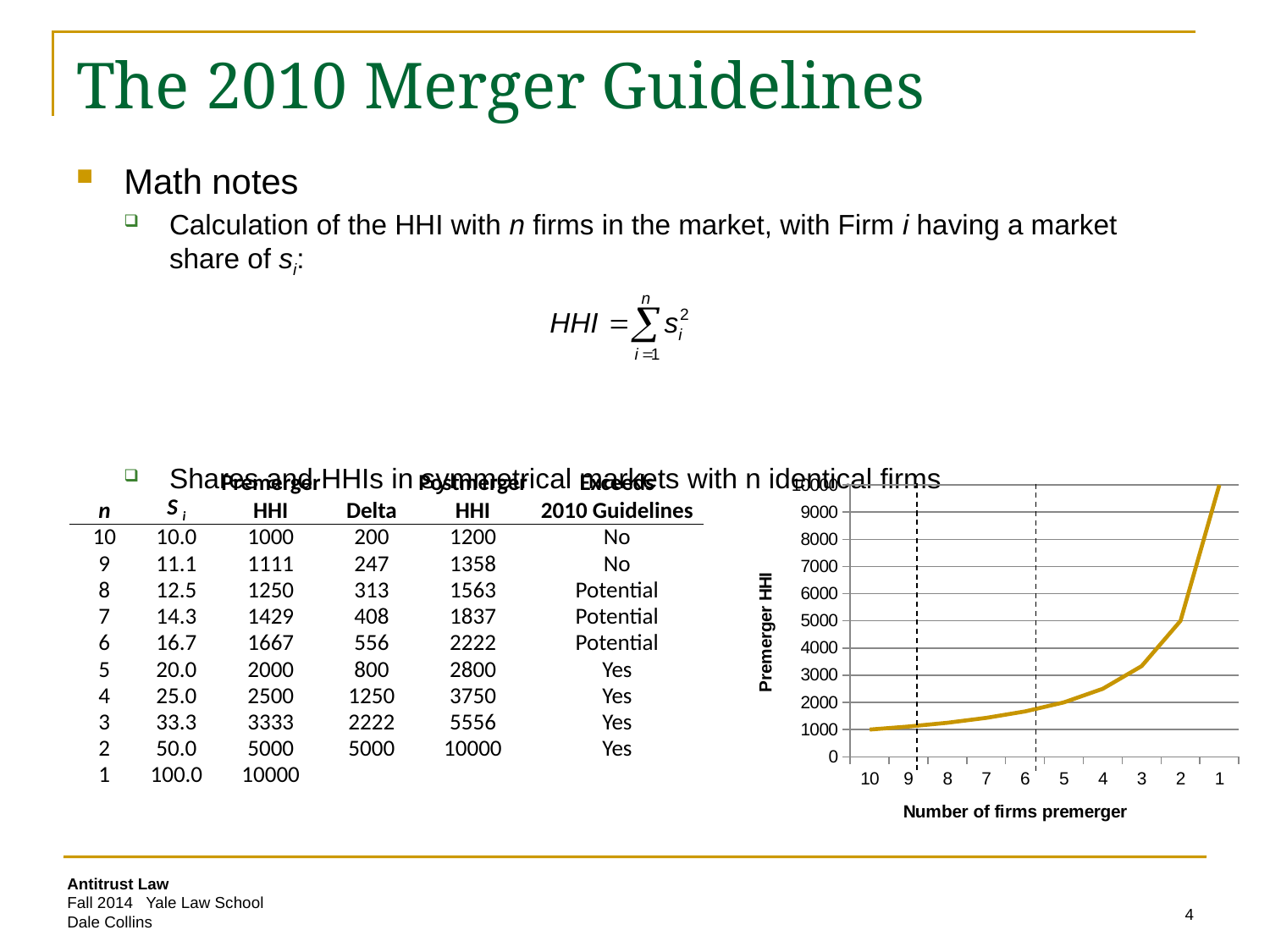
What is the title of the x axis of the chart? Number of firms premerger Is the Premerger HHI for 6 firms greater or less than 2000? less What type of chart is shown on the right side of the slide? line chart What is the Premerger HHI when there is 1 firm premerger? 10000 Does the Premerger HHI rise or fall as you move from left to right along the x axis (from 10 firms to 1 firm)? rise Is the Premerger HHI for 4 firms greater or less than 2000? greater What is the title of the y axis of the chart? Premerger HHI For which number of firms premerger is the Premerger HHI highest? 1 What is the Premerger HHI when there are 10 firms premerger? 1000 For which number of firms premerger is the Premerger HHI lowest? 10 What is the difference between the Premerger HHI at 1 firm and at 10 firms? 9000 What is the Premerger HHI when there are 2 firms premerger? 5000